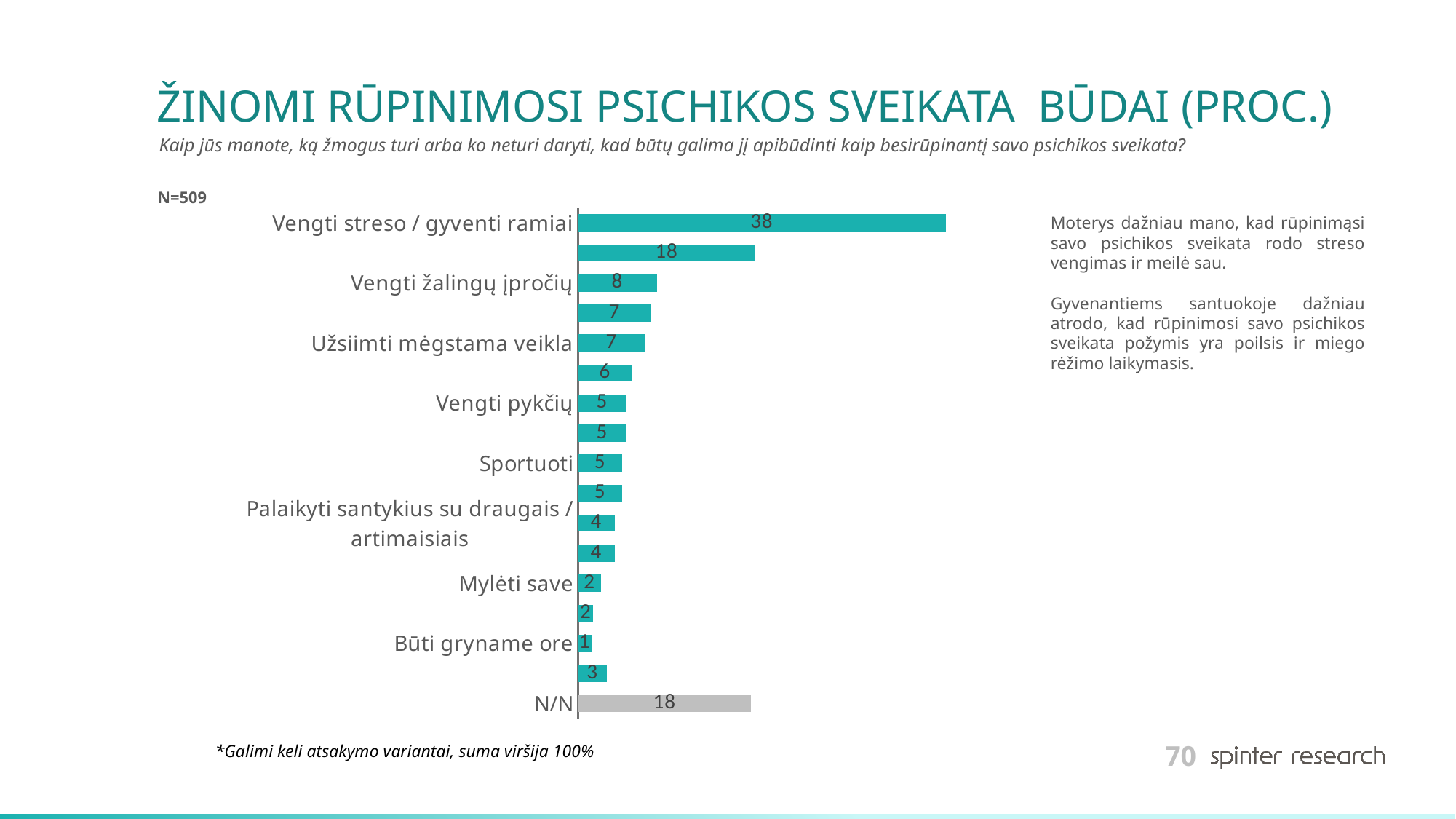
What value is shown for "Vengti žalingų įpročių"? 8 What type of chart is shown on the slide? Bar chart What value is shown for the "N/N" bar? 18 What colour is the "N/N" bar? Grey Which labelled category has the lowest value? Būti gryname ore What value is shown for "Užsiimti mėgstama veikla"? 7 What value is shown for "Vengti streso / gyventi ramiai"? 38 What value is shown for "Būti gryname ore"? 1 Which is larger, the value for "Mylėti save" or the value for "Palaikyti santykius su draugais / artimaisiais"? Palaikyti santykius su draugais / artimaisiais What is the difference between the values for "Vengti streso / gyventi ramiai" and "Vengti žalingų įpročių"? 30 Which labelled category has the highest value? Vengti streso / gyventi ramiai How many bars are plotted in the chart? 17